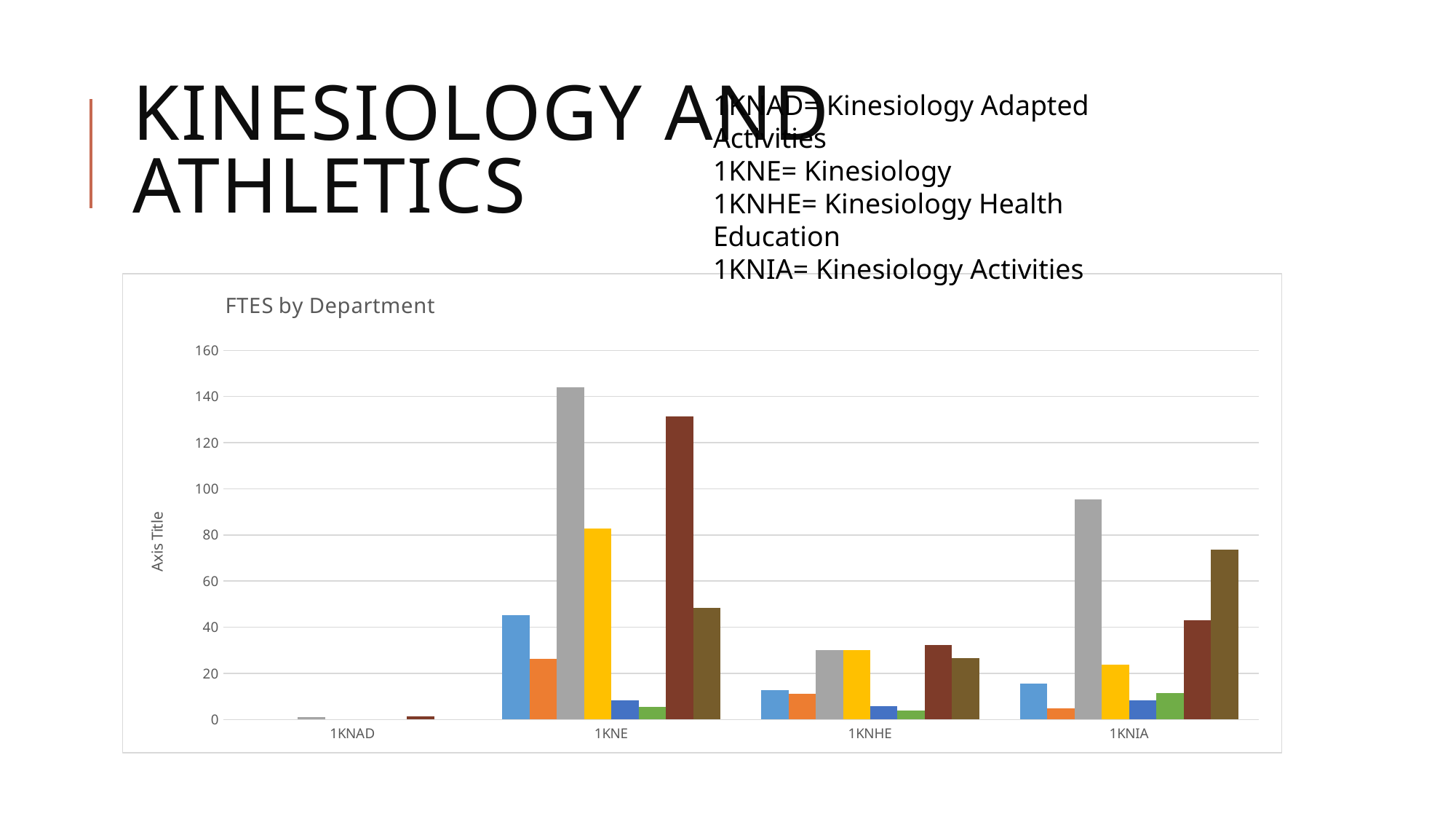
Which department category has the lowest values overall in the chart? 1KNAD What is the label on the vertical axis of the chart? Axis Title Which department category contains the tallest bar in the chart? 1KNE Is the value of the dark red bar for 1KNE greater or less than 120? greater Is the value of the gray bar for 1KNE greater or less than 120? greater What is the title of the chart? FTES by Department Is the value of the gray bar for 1KNIA greater or less than 80? greater What kind of chart is shown on the slide? bar chart Which is larger: the gray bar for 1KNHE or the gray bar for 1KNIA? the gray bar for 1KNIA How many department categories are shown on the x axis of the chart? 4 For 1KNE, which is larger: the gray bar or the yellow bar? the gray bar